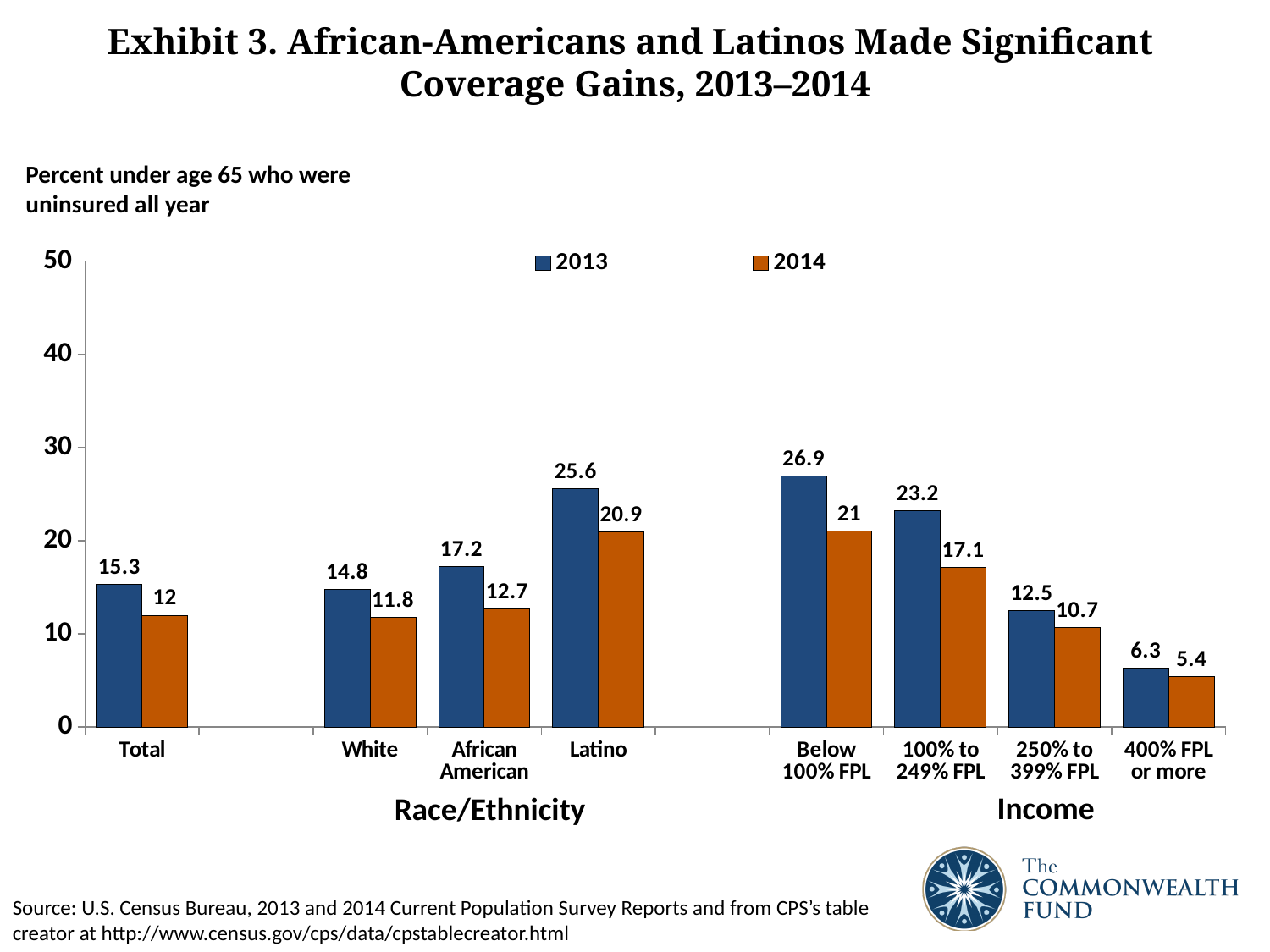
Which colour represents the 2014 series? Orange Which category has the highest 2013 value? Below 100% FPL What is the difference between the 2013 and 2014 values for Latino? 4.7 Which is larger, the 2013 value for White or the 2013 value for African American? African American What was the 2014 value for African American? 12.7 What was the 2013 value for Latino? 25.6 Which category has the lowest 2014 value? 400% FPL or more What was the 2014 value for Below 100% FPL? 21 What is the difference between the 2013 and 2014 values for 100% to 249% FPL? 6.1 How many series does the legend list? 2 How many categories are shown on the x axis? 8 What kind of chart is shown on the slide? Bar chart